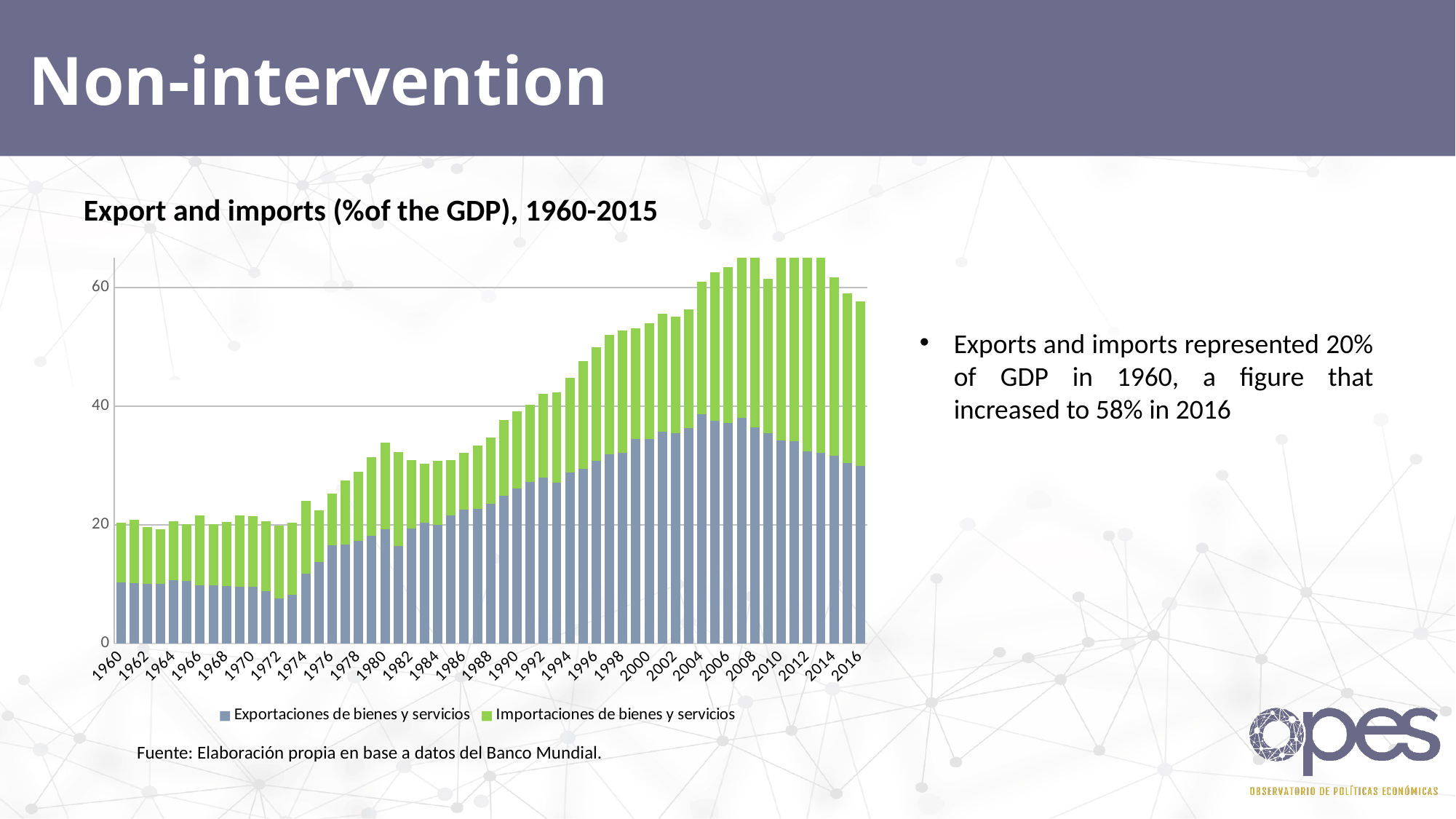
Is the total stacked value for 1960 greater or less than 40? less Is the value for Exportaciones de bienes y servicios in 2016 greater or less than 40? less Is the total stacked value for 1996 greater or less than 40? greater Which year has the larger value for Exportaciones de bienes y servicios, 1972 or 2004? 2004 What kind of chart is shown on the slide? Stacked bar chart What are the two series named in the chart legend? Exportaciones de bienes y servicios; Importaciones de bienes y servicios What is the title of the chart? Export and imports (%of the GDP), 1960-2015 How many series does the chart legend list? 2 Which year has the larger total stacked value, 1960 or 2008? 2008 Overall, do the total stacked values rise or fall from 1960 to 2016? Rise